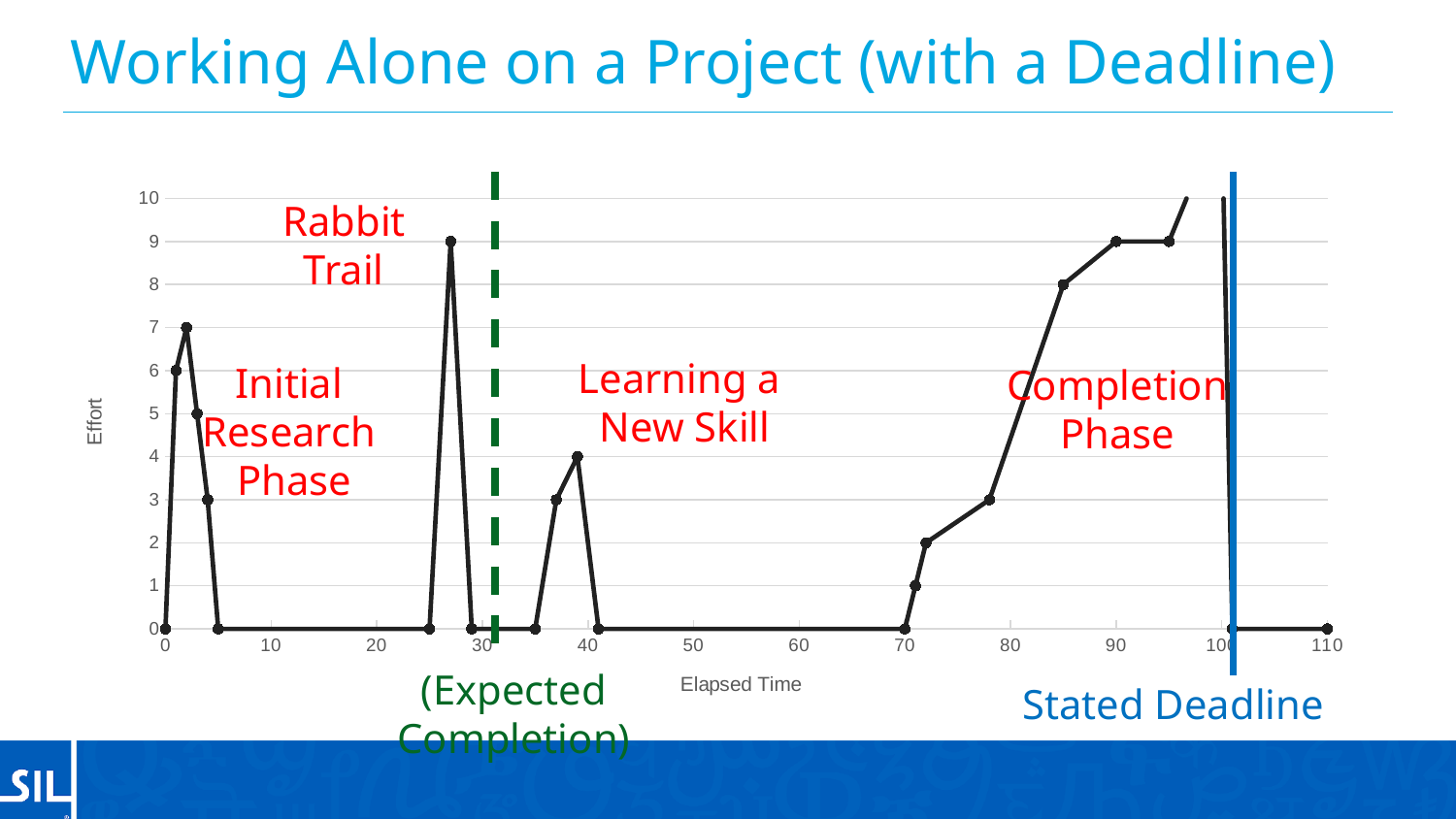
How many labelled phases are annotated on the chart? 4 Which has a higher peak effort, the Rabbit Trail or the Learning a New Skill phase? Rabbit Trail What is the difference between the peak effort of the Rabbit Trail and the peak effort of the Learning a New Skill phase? 5 Is the peak effort during the Learning a New Skill phase greater or less than 5? less Does effort rise or fall over the course of the Completion Phase? rise What is the peak effort value reached during the Rabbit Trail? 9 What kind of chart is shown on the slide? line chart What is the highest effort value reached during the Initial Research Phase? 7 What is the peak effort value reached during the Learning a New Skill phase? 4 What is the label of the vertical axis? Effort What is the title of the chart on the slide? Working Alone on a Project (with a Deadline)